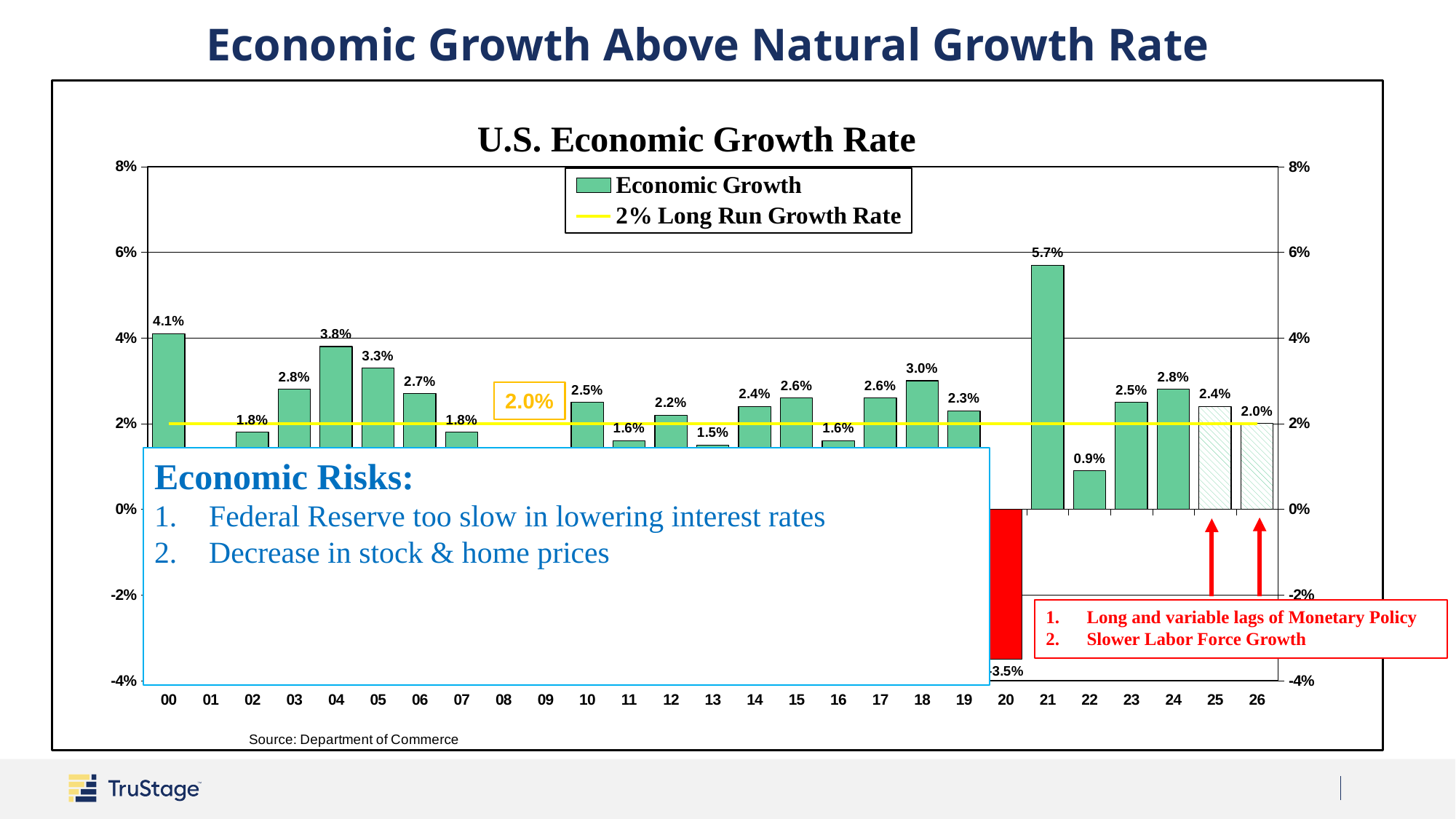
Which year has the highest economic growth rate in the chart? 21 What is the title of the chart? U.S. Economic Growth Rate What is the value for 20 in the U.S. Economic Growth Rate chart? -3.5% Which is larger, the value for 18 or the value for 19? 18 Which year has the lowest economic growth rate in the chart? 20 What is the value for 26 in the U.S. Economic Growth Rate chart? 2.0% How many series does the legend list? 2 What is the difference between the values for 21 and 22? 4.8% What is the value for 21 in the U.S. Economic Growth Rate chart? 5.7% What kind of chart is used to show the economic growth values? Bar chart What is the value for 04 in the U.S. Economic Growth Rate chart? 3.8% Is the value for 00 greater or less than 4%? greater